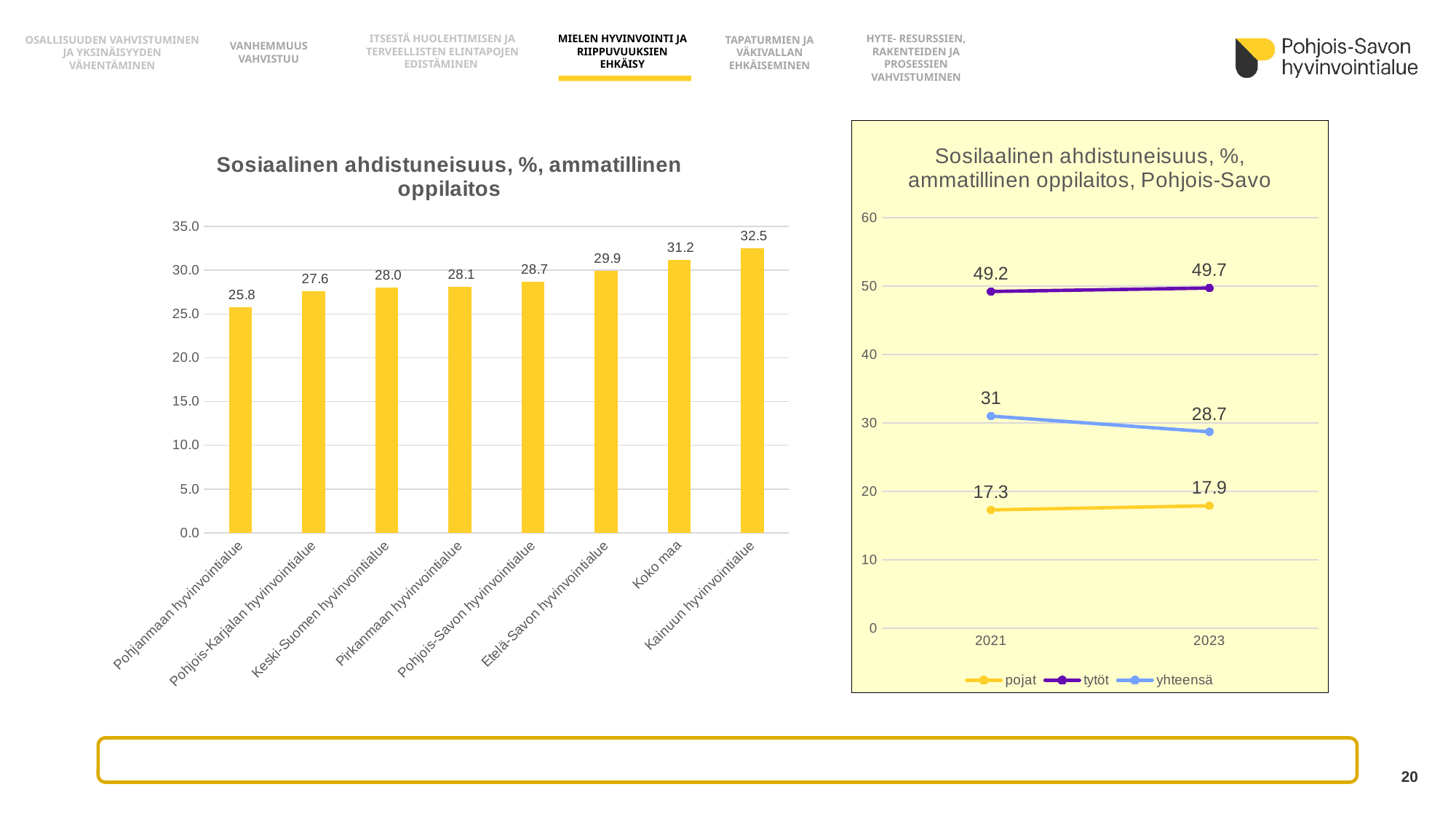
What kind of chart is the chart on the left? bar chart In the line chart on the right, how many series does the legend list? 3 In the bar chart on the left, how many categories are shown? 8 In the line chart on the right, what is the value for tytöt in 2023? 49.7 In the bar chart on the left, what is the difference between Kainuun hyvinvointialue and Pohjanmaan hyvinvointialue? 6.7 In the line chart on the right, what is the value for pojat in 2021? 17.3 In the bar chart on the left, which category has the highest value? Kainuun hyvinvointialue In the bar chart on the left, what is the value for Koko maa? 31.2 In the line chart on the right, does the value for yhteensä rise or fall from 2021 to 2023? fall In the line chart on the right, which is larger in 2021: tytöt or pojat? tytöt In the bar chart on the left, what is the value for Pohjois-Savon hyvinvointialue? 28.7 In the bar chart on the left, which category has the lowest value? Pohjanmaan hyvinvointialue